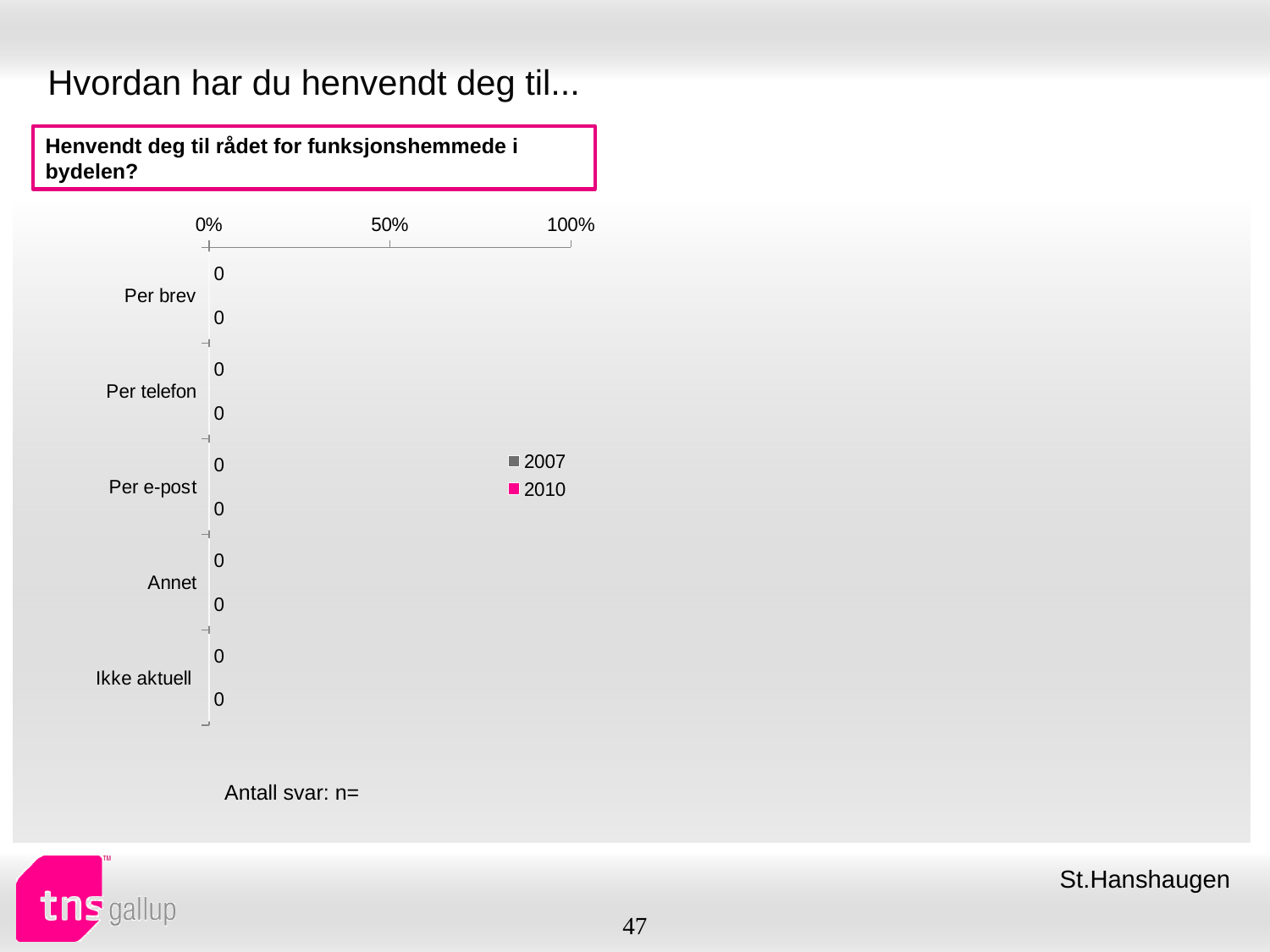
What is the value for Annet in 2010? 0 What is the value for Ikke aktuell in 2007? 0 What kind of chart is shown on the slide? bar chart What is the title of the chart? Henvendt deg til rådet for funksjonshemmede i bydelen? How many series does the chart's legend list? 2 Is the value for Per telefon in 2007 greater or less than 50%? less What is the value for Per telefon in 2010? 0 What is the difference between the 2007 and 2010 values for Per e-post? 0 What is the value for Per e-post in 2007? 0 What is the value for Per brev in 2007? 0 Which series is shown in pink in the legend? 2010 How many categories are shown on the chart? 5